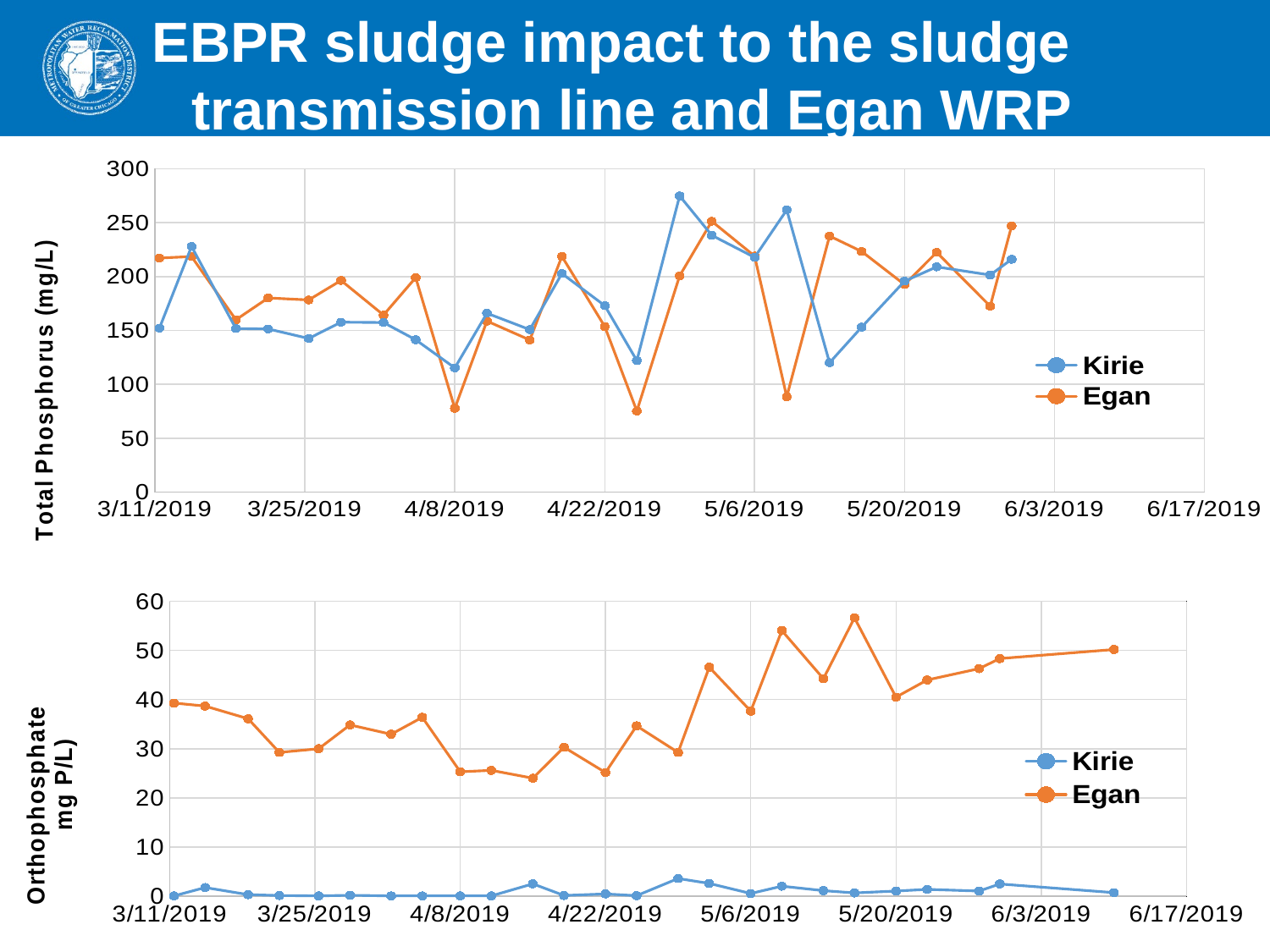
In the bottom chart, which series has the highest value overall, Kirie or Egan? Egan What kind of chart is the bottom chart on the slide? line chart What kind of chart is the top chart on the slide? line chart In the bottom chart, is the Kirie value at 3/11/2019 greater or less than 10? less How many series does the legend of the top chart list? 2 In the bottom chart, is the Egan value at 4/8/2019 greater or less than 30? less What is the y-axis title of the top chart? Total Phosphorus (mg/L) In the top chart, which series has the higher value at 4/8/2019, Kirie or Egan? Kirie What is the y-axis title of the bottom chart? Orthophosphate mg P/L In the top chart, is the Egan value at 3/11/2019 greater or less than 200? greater